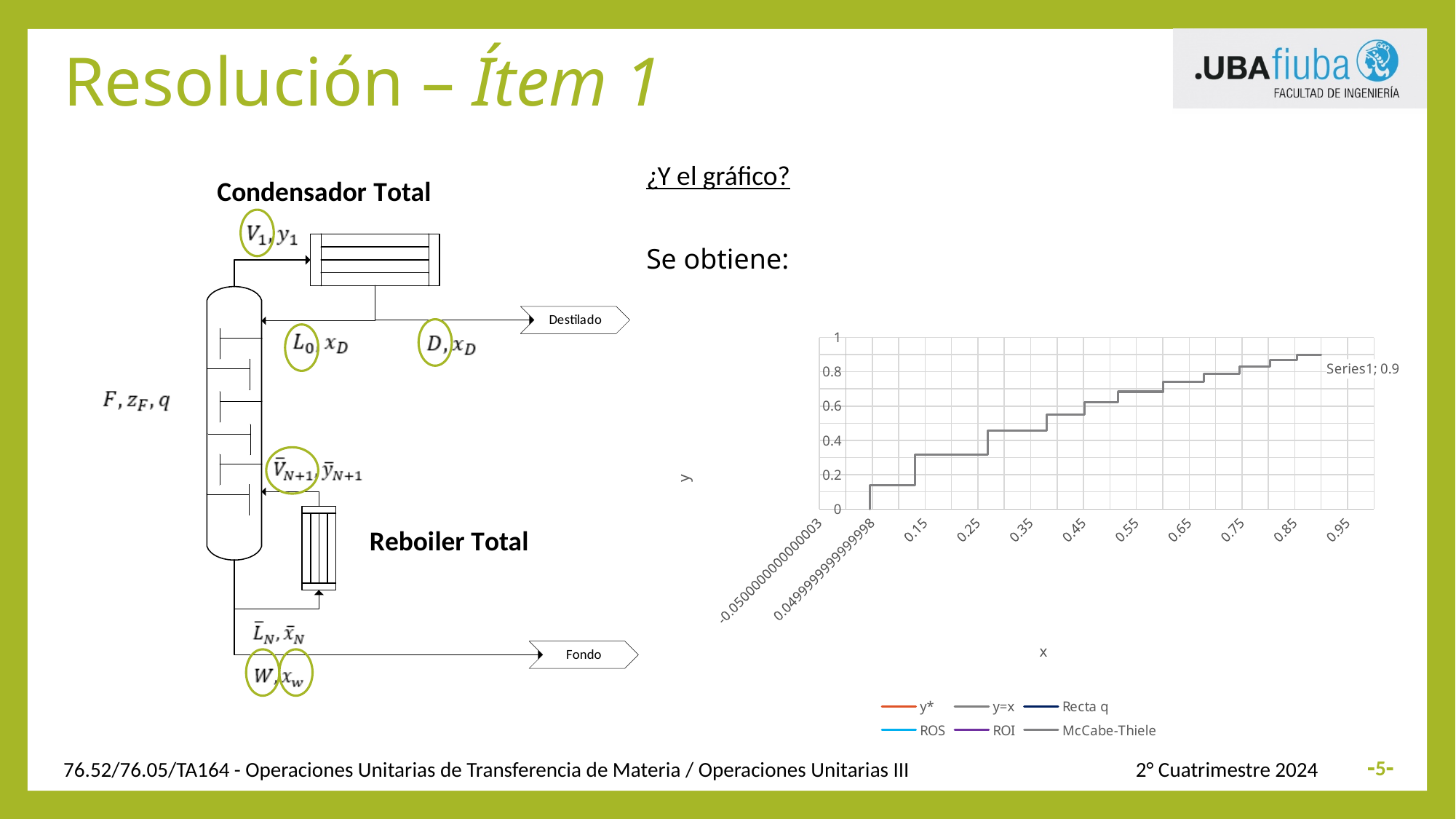
Which series name appears in the data label at the top right of the plotted line? Series1 What is the title of the vertical axis of the chart? y Is the highest y value reached by the plotted staircase line greater or less than 1? less Do the plotted values in the chart rise or fall as x increases? rise What value is shown by the data label at the end of the plotted line in the chart? 0.9 What kind of chart is shown on the right side of the slide? line chart How many series does the legend of the chart list? 6 What is the last legend entry listed in the chart's legend? McCabe-Thiele What is the highest tick value shown on the y axis of the chart? 1 Is the highest y value reached by the plotted staircase line greater or less than 0.8? greater